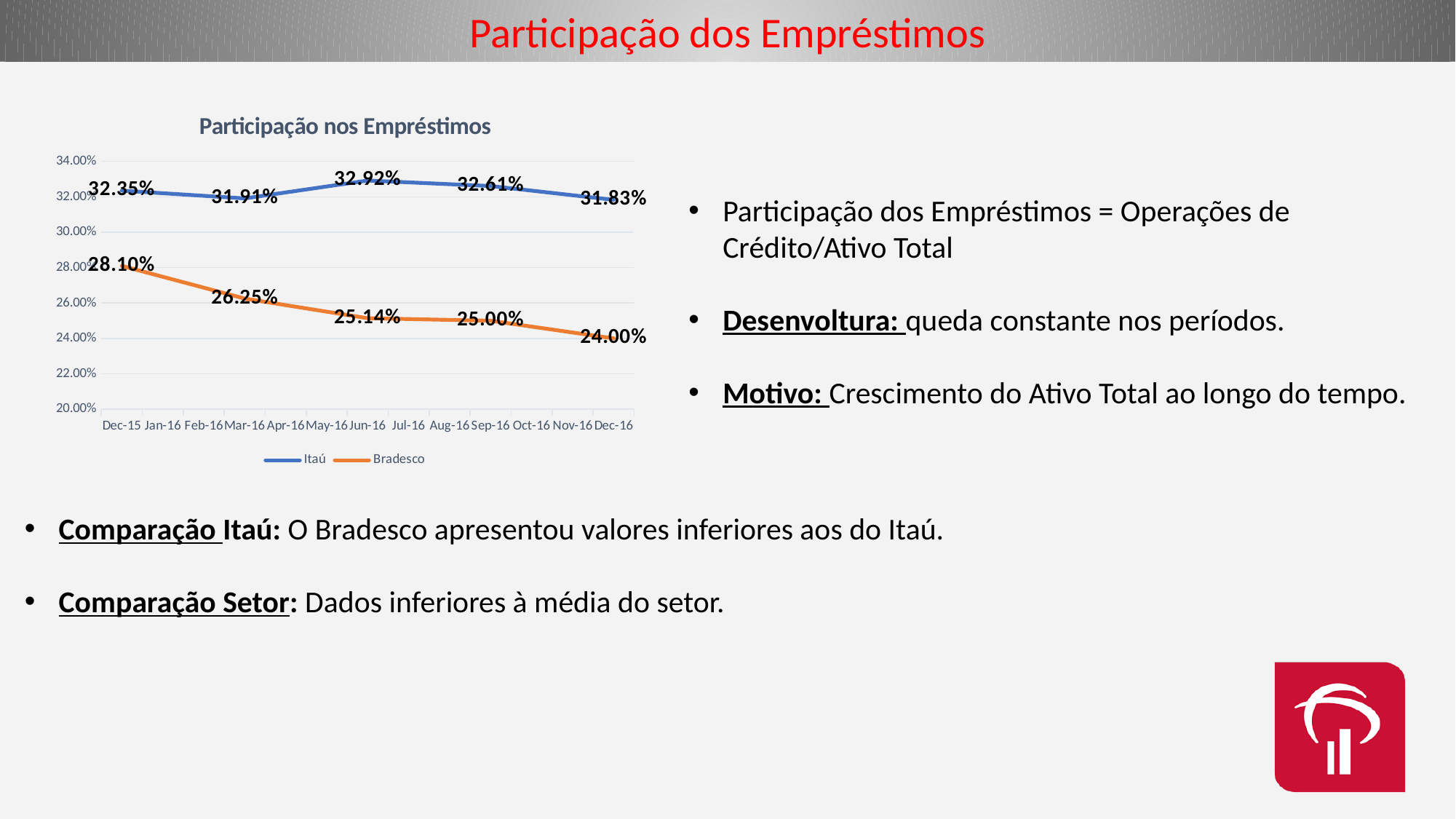
At which labelled date is the Itaú value highest? Jun-16 Do the Bradesco values rise or fall from Dec-15 to Dec-16? fall What is the title of the chart? Participação nos Empréstimos What is the value for Bradesco at Dec-15? 28.10% What is the difference between the Bradesco values at Dec-15 and Dec-16? 4.10% What type of chart is shown on the slide? line chart How many series does the legend list? 2 At which labelled date is the Bradesco value lowest? Dec-16 What is the value for Bradesco at Dec-16? 24.00% What is the difference between the Itaú and Bradesco values at Dec-16? 7.83% Which series has the larger value at Sep-16, Itaú or Bradesco? Itaú What is the value for Itaú at Jun-16? 32.92%